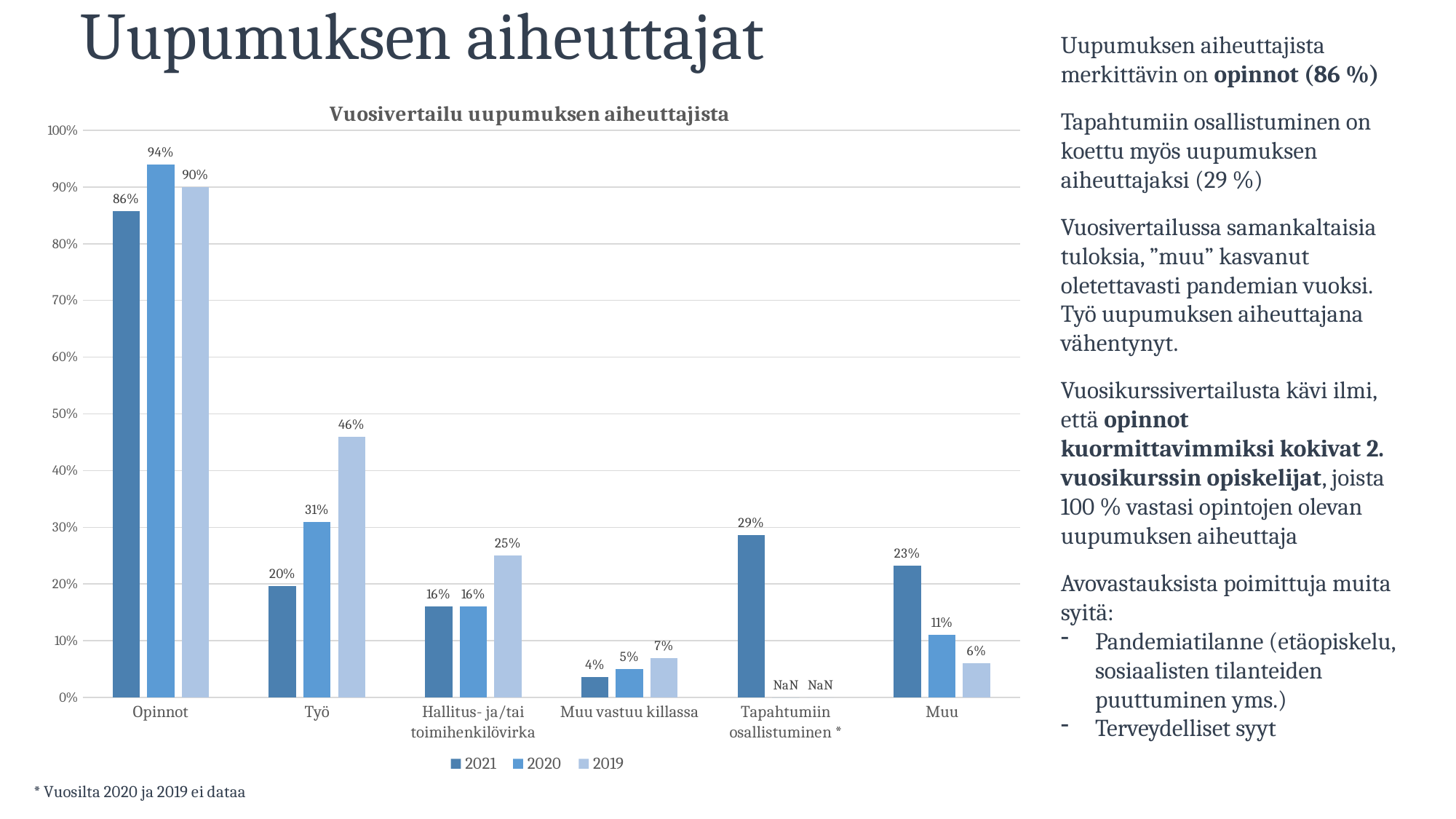
What is the value for Työ in the 2019 series? 46% How many series does the legend list? 3 What is the value for Opinnot in the 2021 series? 86% Which category has the lowest value in the 2021 series? Muu vastuu killassa What is the value for Muu in the 2020 series? 11% What kind of chart is shown on the slide? Bar chart Which category has the highest value in the 2020 series? Opinnot How many categories are shown on the x axis? 6 Which is larger for Muu: the 2021 value or the 2019 value? 2021 What is the title of the chart? Vuosivertailu uupumuksen aiheuttajista What is the difference between the 2020 and 2021 values for Opinnot? 8% What is the value for Tapahtumiin osallistuminen in the 2021 series? 29%